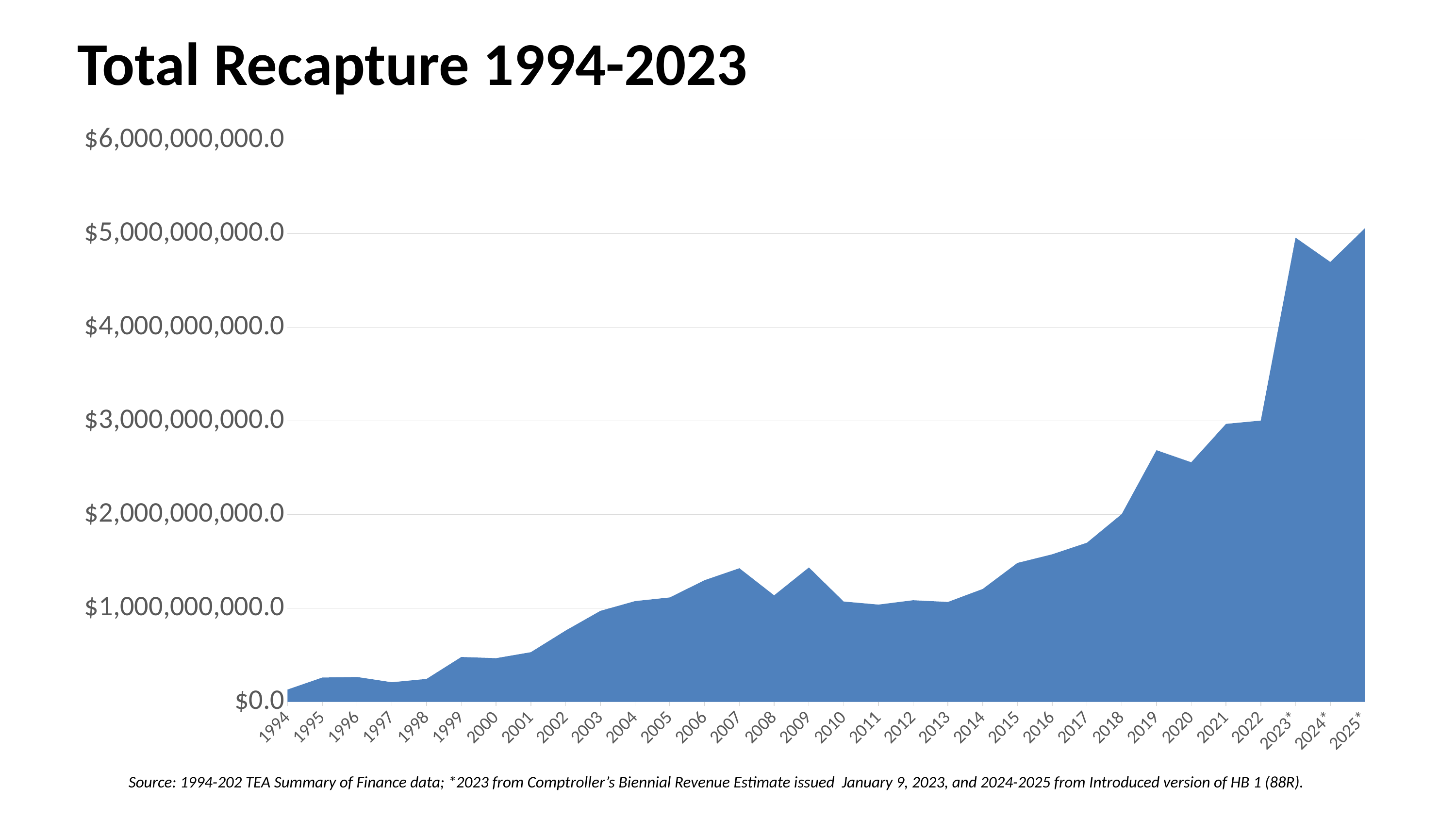
Is the value for 2024* greater or less than $5,000,000,000.0? less Which is larger, the value for 2007 or the value for 2008? 2007 Which is larger, the value for 2019 or the value for 2020? 2019 Which year has the lowest total recapture? 1994 How many years are plotted along the x axis? 32 Overall, do the values rise or fall from 1994 to 2025*? Rise What kind of chart is shown on the slide? Area chart What is the title of the chart? Total Recapture 1994-2023 Is the value for 2023* greater or less than $4,000,000,000.0? greater Is the value for 2001 greater or less than $1,000,000,000.0? less